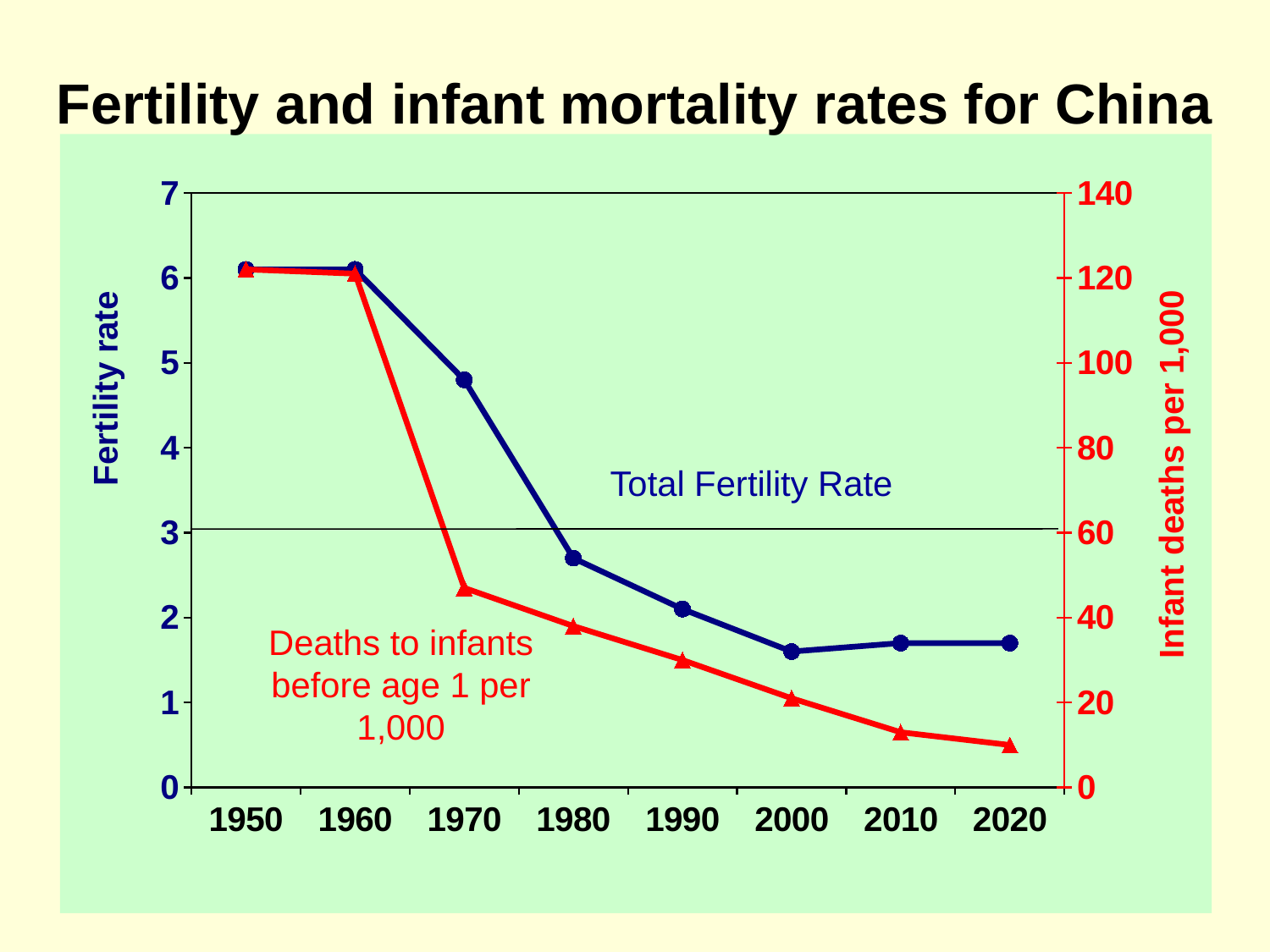
What is the title of the chart? Fertility and infant mortality rates for China Is the Total Fertility Rate for 1980 greater or less than 3? less What kind of chart is shown on the slide? line chart Is the Total Fertility Rate for 1970 greater or less than 4? greater Is the Total Fertility Rate for 2000 greater or less than 2? less How many years are plotted along the x axis? 8 Which year has the lowest number of infant deaths per 1,000? 2020 What is the label of the right-hand vertical axis? Infant deaths per 1,000 How many data series are plotted on the chart? 2 Does the Total Fertility Rate generally rise or fall from 1950 to 2020? fall